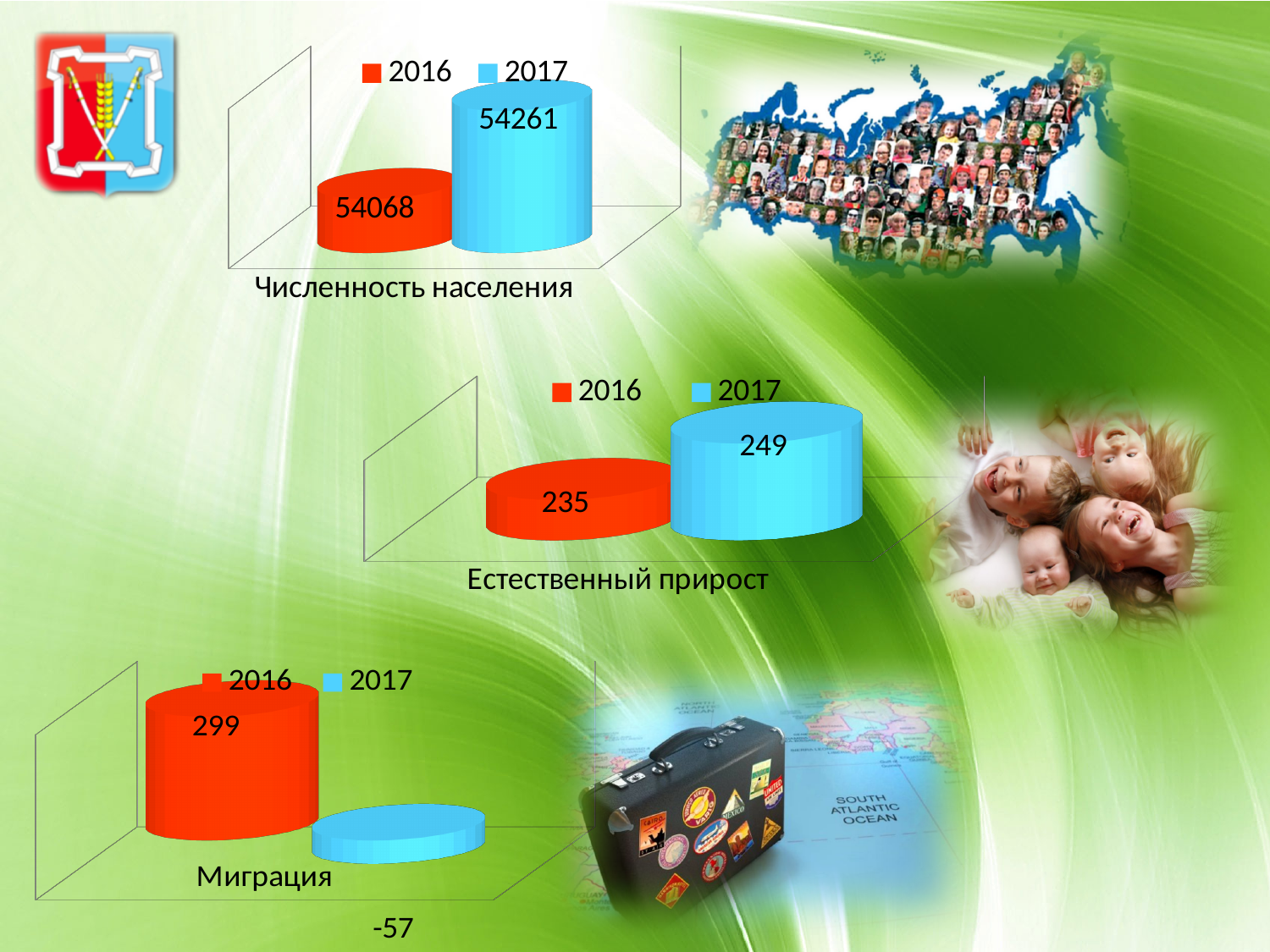
In the 'Численность населения' chart, what is the difference between the 2017 and 2016 values? 193 In the 'Численность населения' chart, what is the value for 2016? 54068 In the 'Естественный прирост' chart, what is the value for 2016? 235 In the 'Миграция' chart, what is the value for 2017? -57 In the 'Миграция' chart, what is the value for 2016? 299 In the 'Миграция' chart, which year has the lower value? 2017 In the 'Естественный прирост' chart, what is the difference between the 2017 and 2016 values? 14 What kind of chart is the 'Миграция' chart? bar chart In the 'Естественный прирост' chart, which year has the higher value? 2017 In the 'Естественный прирост' chart, what is the value for 2017? 249 How many series does the legend of the 'Численность населения' chart list? 2 In the 'Численность населения' chart, what is the value for 2017? 54261